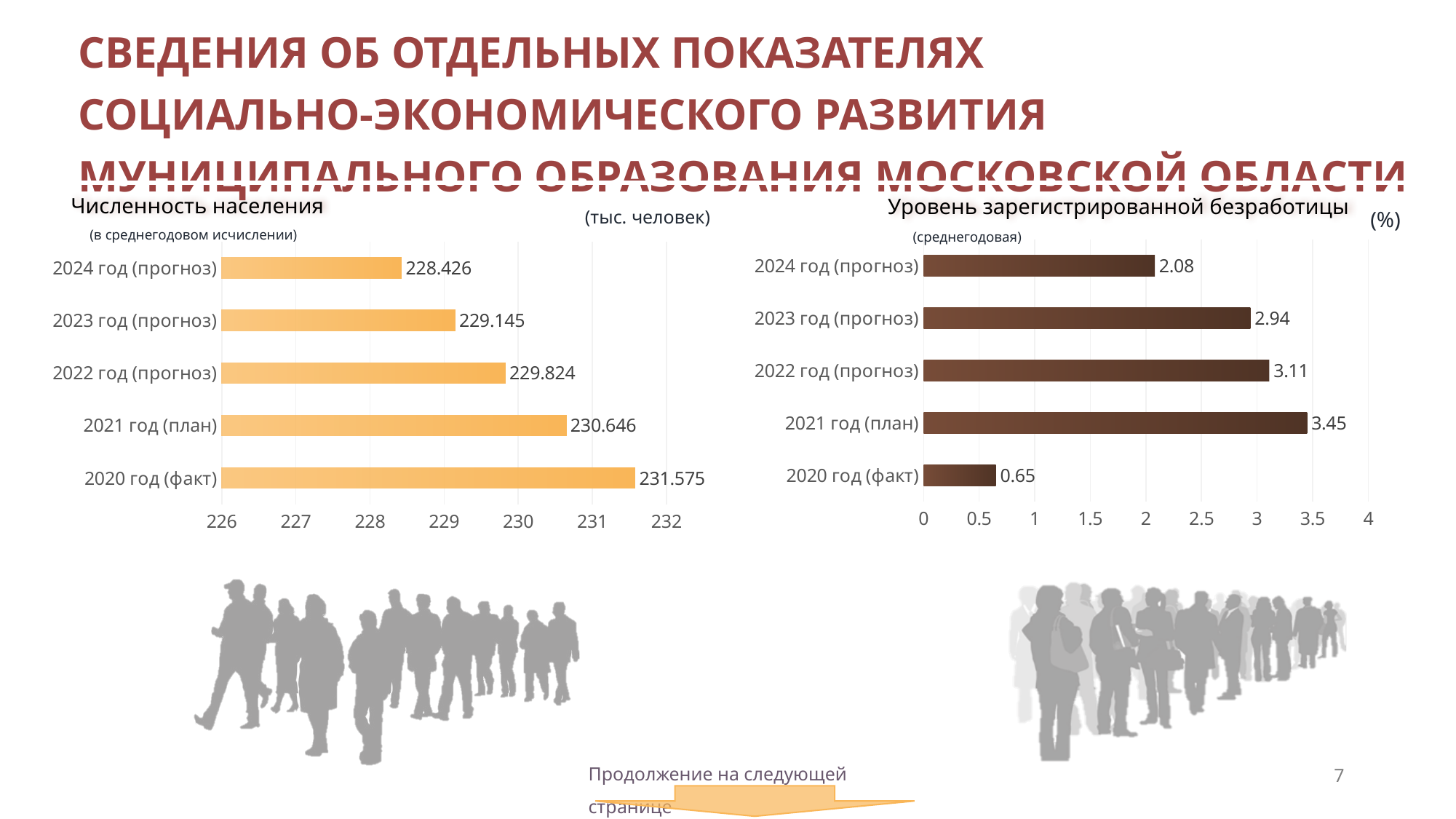
What kind of chart is the 'Численность населения' chart? bar chart In the 'Уровень зарегистрированной безработицы' chart, what is the value for 2021 год (план)? 3.45 In the 'Уровень зарегистрированной безработицы' chart, which category has the highest value? 2021 год (план) In the 'Численность населения' chart, how many categories are shown? 5 In the 'Уровень зарегистрированной безработицы' chart, what is the difference between the values for 2022 год (прогноз) and 2023 год (прогноз)? 0.17 In the 'Численность населения' chart, which category has the lowest value? 2024 год (прогноз) In the 'Уровень зарегистрированной безработицы' chart, what is the value for 2020 год (факт)? 0.65 In the 'Уровень зарегистрированной безработицы' chart, which is larger: the value for 2023 год (прогноз) or 2024 год (прогноз)? 2023 год (прогноз) In the 'Численность населения' chart, what is the value for 2020 год (факт)? 231.575 In the 'Численность населения' chart, what is the value for 2022 год (прогноз)? 229.824 What unit is shown next to the title of the 'Численность населения' chart? тыс. человек In the 'Численность населения' chart, what is the difference between the values for 2020 год (факт) and 2024 год (прогноз)? 3.149